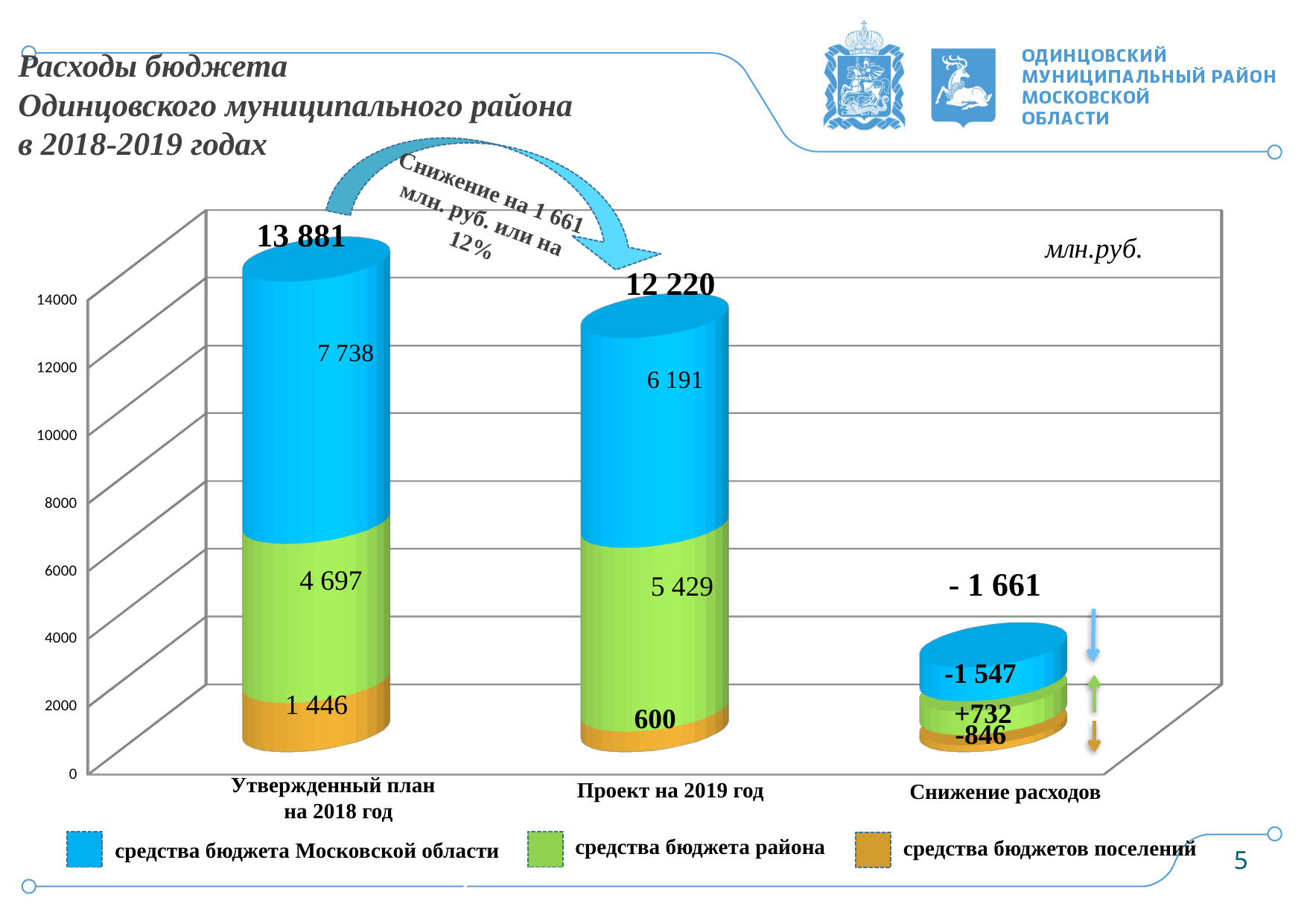
What type of chart is shown on the slide? stacked bar chart What unit is indicated in the top right of the chart area? млн.руб. What is the difference between средства бюджетов поселений for Утвержденный план на 2018 год and for Проект на 2019 год? 846 What is the total of the stacked bar for Проект на 2019 год? 12 220 What is the value of средства бюджетов поселений for Проект на 2019 год? 600 What is the value of средства бюджета района for Проект на 2019 год? 5 429 How many categories are shown on the x axis? 3 What is the value of средства бюджета Московской области for Снижение расходов? -1 547 What is the value of средства бюджета Московской области for Утвержденный план на 2018 год? 7 738 What is the total of the stacked bar for Утвержденный план на 2018 год? 13 881 Which is larger: средства бюджета района for Утвержденный план на 2018 год or for Проект на 2019 год? Проект на 2019 год How many series does the legend list? 3